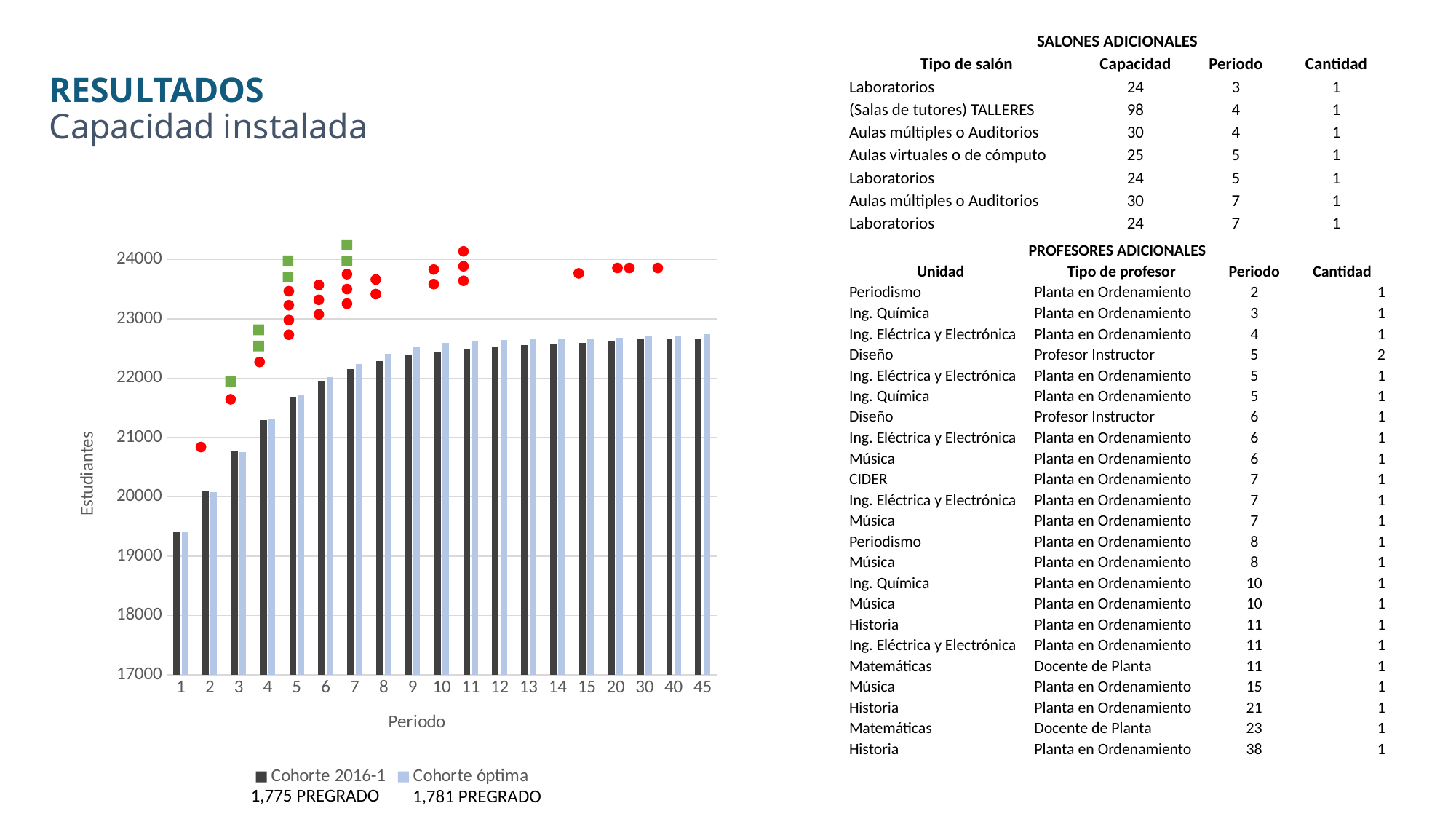
How many series does the chart legend list? 2 Is the Cohorte 2016-1 value for period 1 greater or less than 20000? less Is the Cohorte óptima value for period 3 greater or less than 21000? less Is the Cohorte óptima value for period 5 greater or less than 22000? less How many periods are shown on the x axis of the chart? 19 What is the label of the chart's vertical axis? Estudiantes Do the Cohorte 2016-1 bars rise or fall as the period increases along the x axis? rise What kind of chart is shown on the slide? bar chart What is the label of the chart's horizontal axis? Periodo